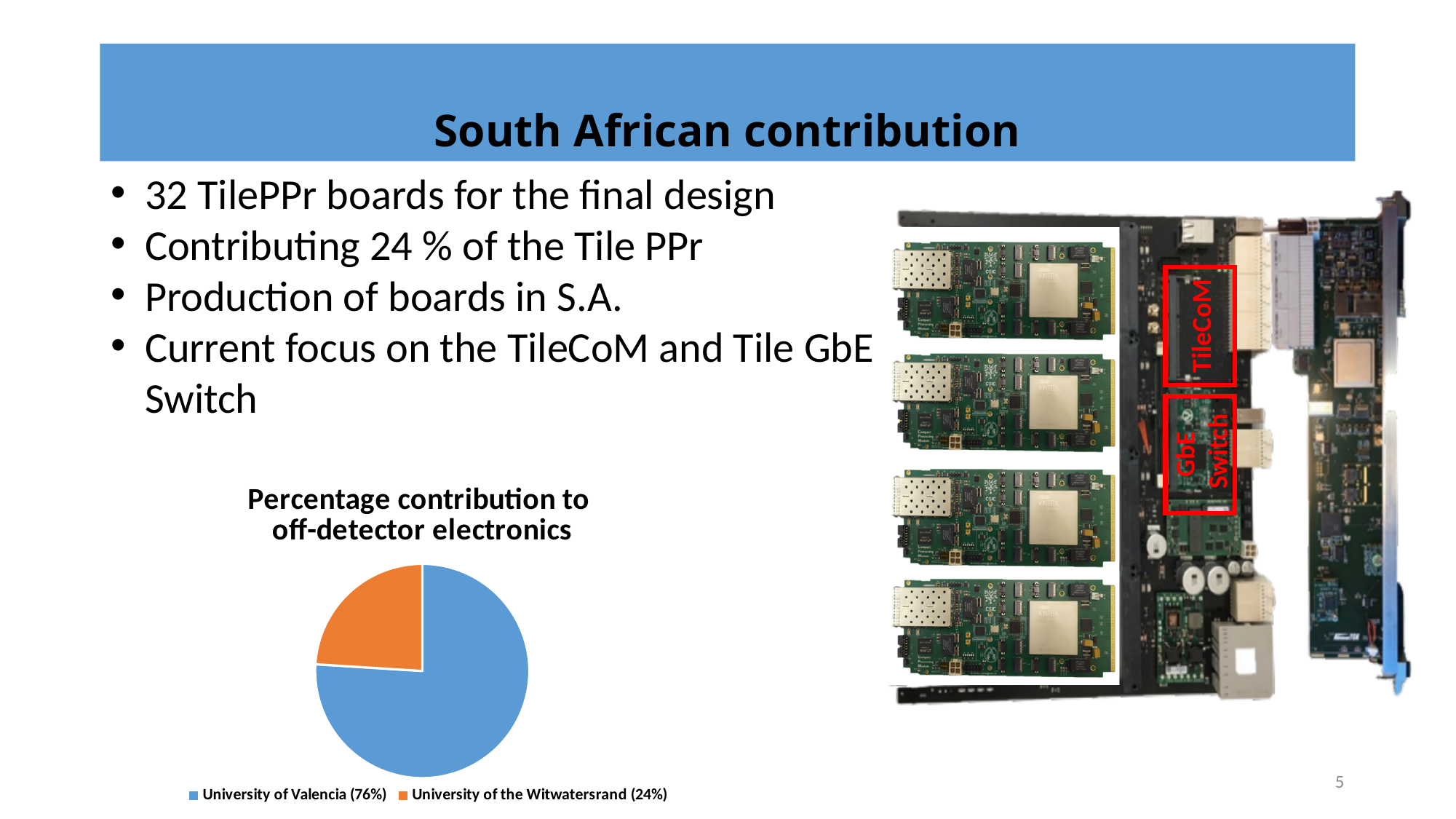
Which is larger: the share for the University of Valencia or the share for the University of the Witwatersrand? University of Valencia What share of the pie does the University of the Witwatersrand have? 24% What kind of chart is shown on the slide? pie chart How many slices does the pie chart have? 2 What share of the pie does the University of Valencia have? 76% What is the difference in percentage points between the University of Valencia's share and the University of the Witwatersrand's share? 52 What is the title of the chart? Percentage contribution to off-detector electronics Which institution has the largest slice of the pie? University of Valencia What colour is the slice for the University of the Witwatersrand? orange How many entries does the legend list? 2 Which institution has the smallest slice of the pie? University of the Witwatersrand